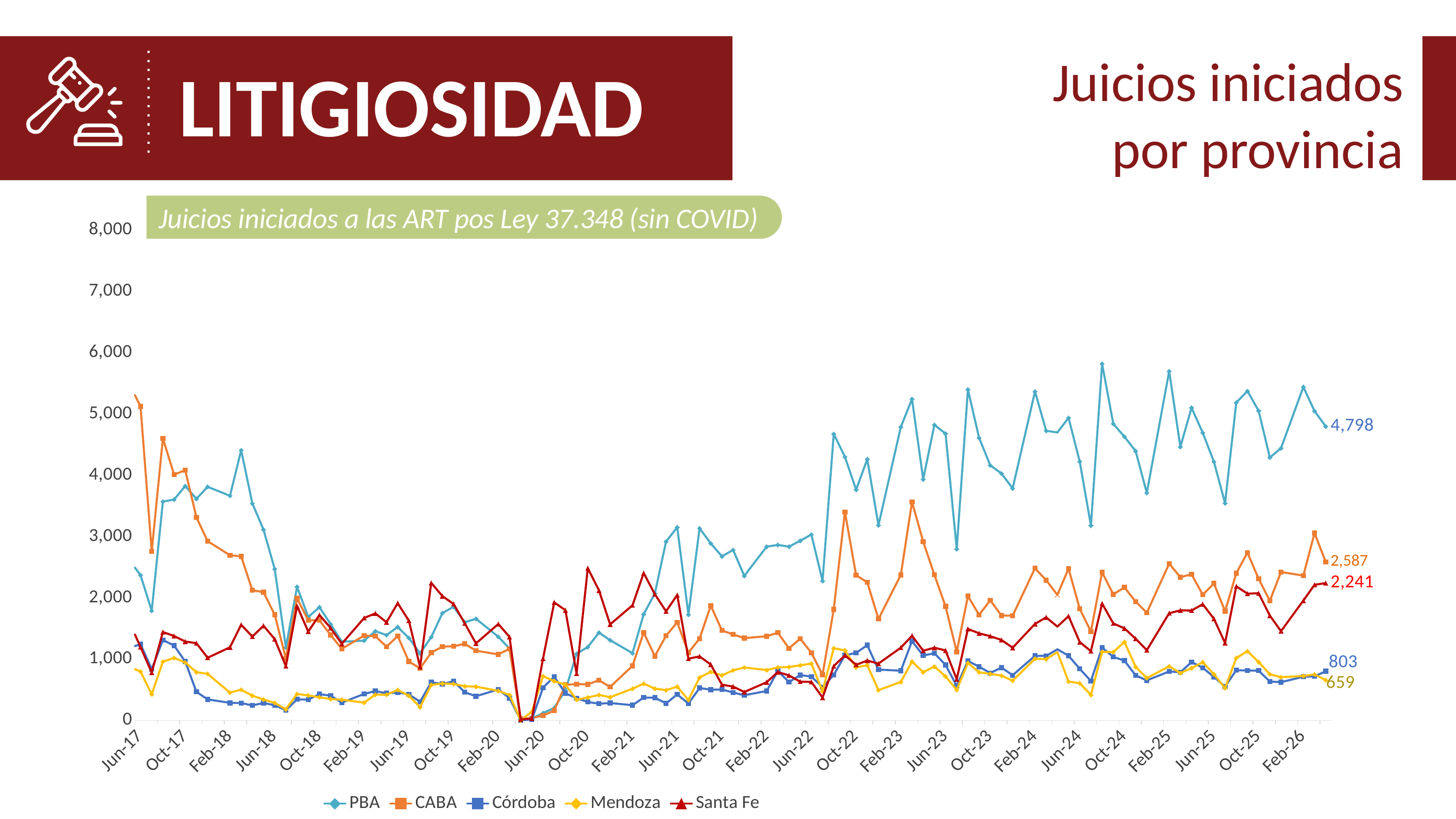
What is the last labelled value for the PBA series? 4,798 How many series does the legend list? 5 What type of chart is shown on the slide? line chart What is the difference between the final labelled values of Córdoba and Mendoza? 144 Is the value for CABA at Jun-17 greater or less than 5,000? greater What is the last labelled value for the Santa Fe series? 2,241 What is the last labelled value for the Córdoba series? 803 What is the difference between the final labelled values of PBA and CABA? 2,211 Which series has the lowest final labelled value? Mendoza Which series has the highest final labelled value? PBA What is the last labelled value for the CABA series? 2,587 What is the last labelled value for the Mendoza series? 659